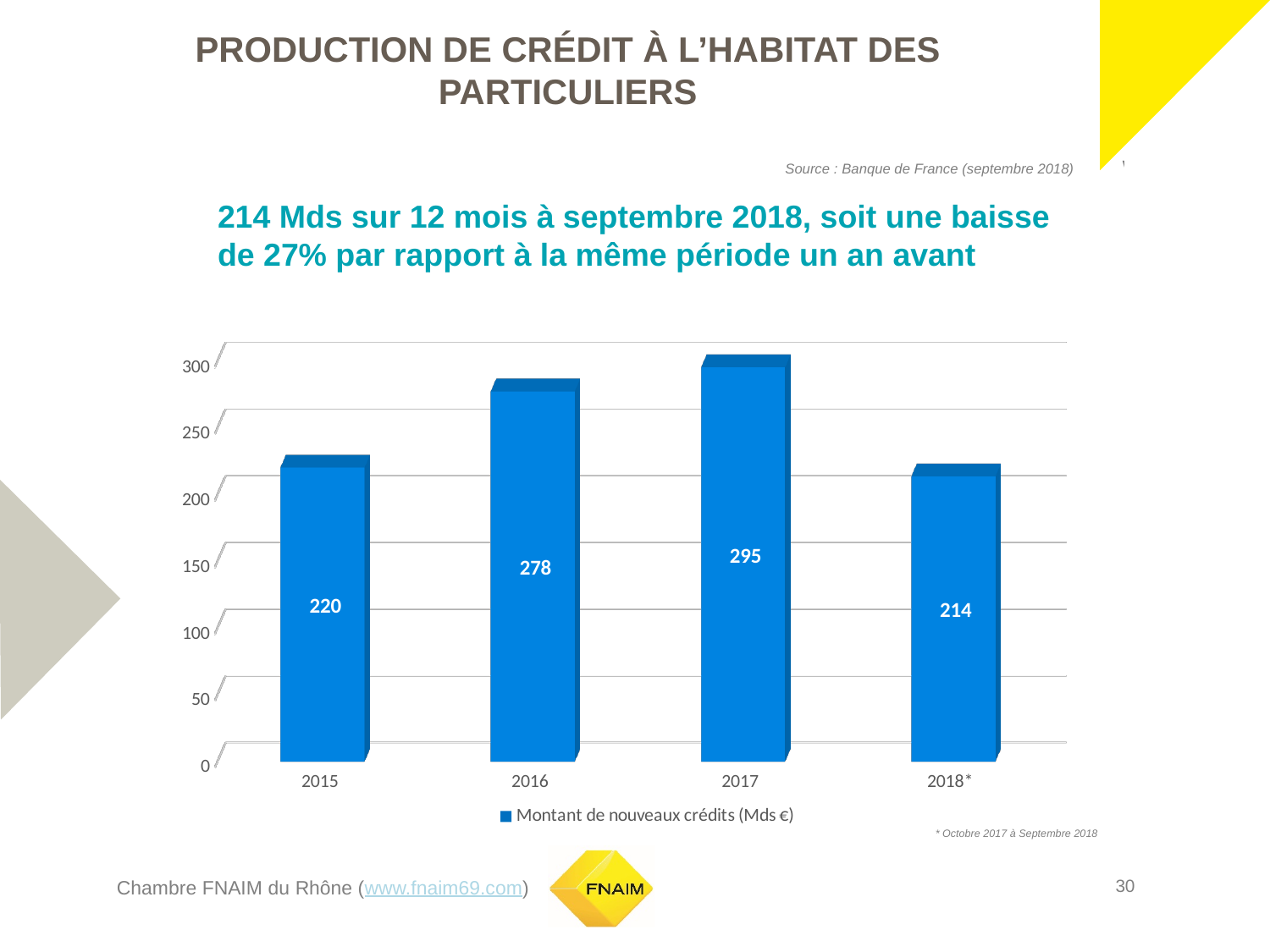
What is the value for 2016? 278 What kind of chart is shown? bar chart Which is larger, the value for 2015 or the value for 2018*? 2015 How many years are shown on the x axis? 4 What is the legend entry for the series? Montant de nouveaux crédits (Mds €) What is the difference between the values for 2017 and 2018*? 81 What is the value for 2018*? 214 What is the value for 2015? 220 What is the difference between the values for 2016 and 2015? 58 Which year has the lowest value? 2018* Which year has the highest value? 2017 Is the value for 2017 greater or less than 250? greater